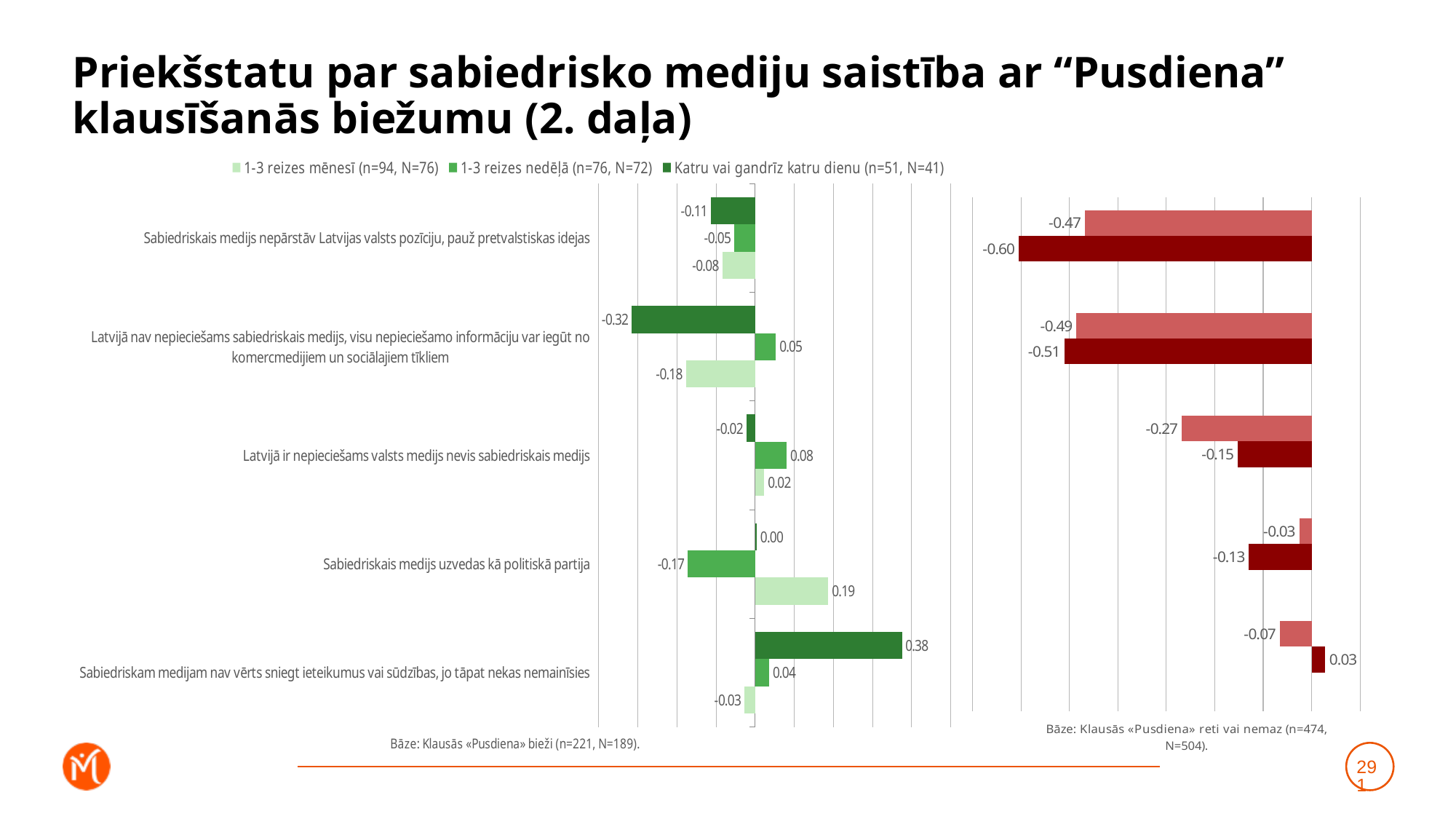
In the left chart, which category has the lowest value for '1-3 reizes mēnesī'? Latvijā nav nepieciešams sabiedriskais medijs, visu nepieciešamo informāciju var iegūt no komercmedijiem un sociālajiem tīkliem In the left chart, for 'Sabiedriskais medijs nepārstāv Latvijas valsts pozīciju, pauž pretvalstiskas idejas', which series has the larger value: '1-3 reizes nedēļā' or 'Katru vai gandrīz katru dienu'? 1-3 reizes nedēļā In the left chart, what is the value for 'Katru vai gandrīz katru dienu' for 'Sabiedriskam medijam nav vērts sniegt ieteikumus vai sūdzības, jo tāpat nekas nemainīsies'? 0.38 In the left chart, what is the value for '1-3 reizes nedēļā' for 'Latvijā ir nepieciešams valsts medijs nevis sabiedriskais medijs'? 0.08 In the left chart, what is the value for '1-3 reizes mēnesī' for 'Sabiedriskais medijs uzvedas kā politiskā partija'? 0.19 How many series does the legend of the left chart list? 3 How many categories are shown in the left chart? 5 In the left chart, which category has the highest value for 'Katru vai gandrīz katru dienu'? Sabiedriskam medijam nav vērts sniegt ieteikumus vai sūdzības, jo tāpat nekas nemainīsies In the right chart, what is the value of the dark red bar for 'Sabiedriskais medijs nepārstāv Latvijas valsts pozīciju, pauž pretvalstiskas idejas'? -0.60 In the left chart, what is the value for 'Katru vai gandrīz katru dienu' for 'Latvijā nav nepieciešams sabiedriskais medijs, visu nepieciešamo informāciju var iegūt no komercmedijiem un sociālajiem tīkliem'? -0.32 What kind of chart is the left chart? Bar chart In the left chart, what is the difference between the '1-3 reizes mēnesī' value (0.19) and the '1-3 reizes nedēļā' value (-0.17) for 'Sabiedriskais medijs uzvedas kā politiskā partija'? 0.36